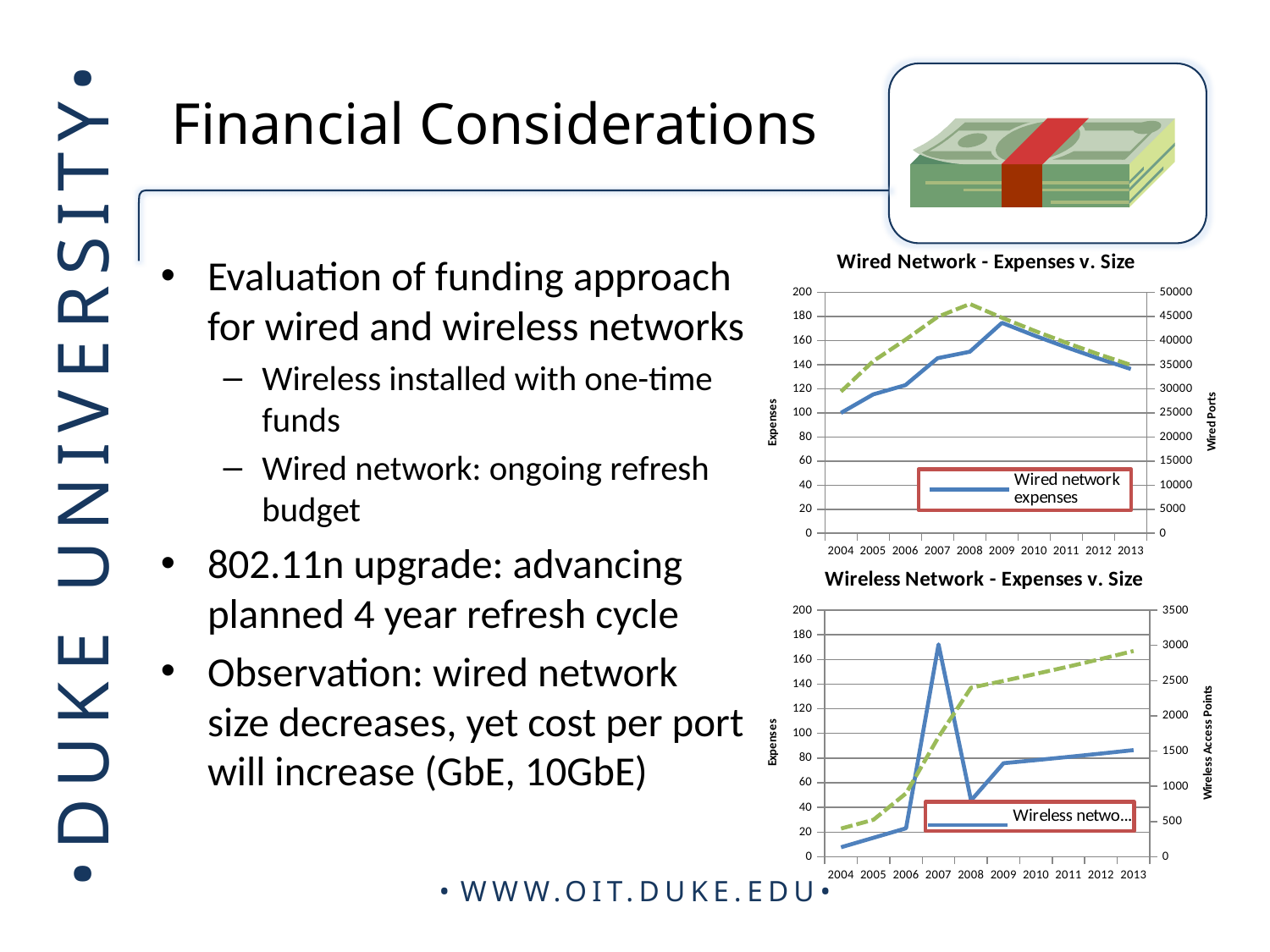
In the "Wired Network - Expenses v. Size" chart, how many years are shown on the x axis? 10 In the "Wireless Network - Expenses v. Size" chart, which year has the highest wireless network expenses? 2007 In the "Wireless Network - Expenses v. Size" chart, is the wireless network expenses value for 2007 greater or less than 160? greater In the "Wireless Network - Expenses v. Size" chart, is the wireless network expenses value for 2004 greater or less than 20? less What kind of chart is the "Wired Network - Expenses v. Size" chart? line chart In the "Wired Network - Expenses v. Size" chart, is the wired network expenses value for 2009 greater or less than 160? greater In the "Wireless Network - Expenses v. Size" chart, which year has larger wireless network expenses, 2007 or 2008? 2007 In the "Wired Network - Expenses v. Size" chart, do wired network expenses rise or fall from 2009 to 2013? fall In the "Wired Network - Expenses v. Size" chart, which year has the lowest wired network expenses? 2004 What is the label on the right-hand vertical axis of the "Wireless Network - Expenses v. Size" chart? Wireless Access Points In the "Wired Network - Expenses v. Size" chart, which year has the highest wired network expenses? 2009